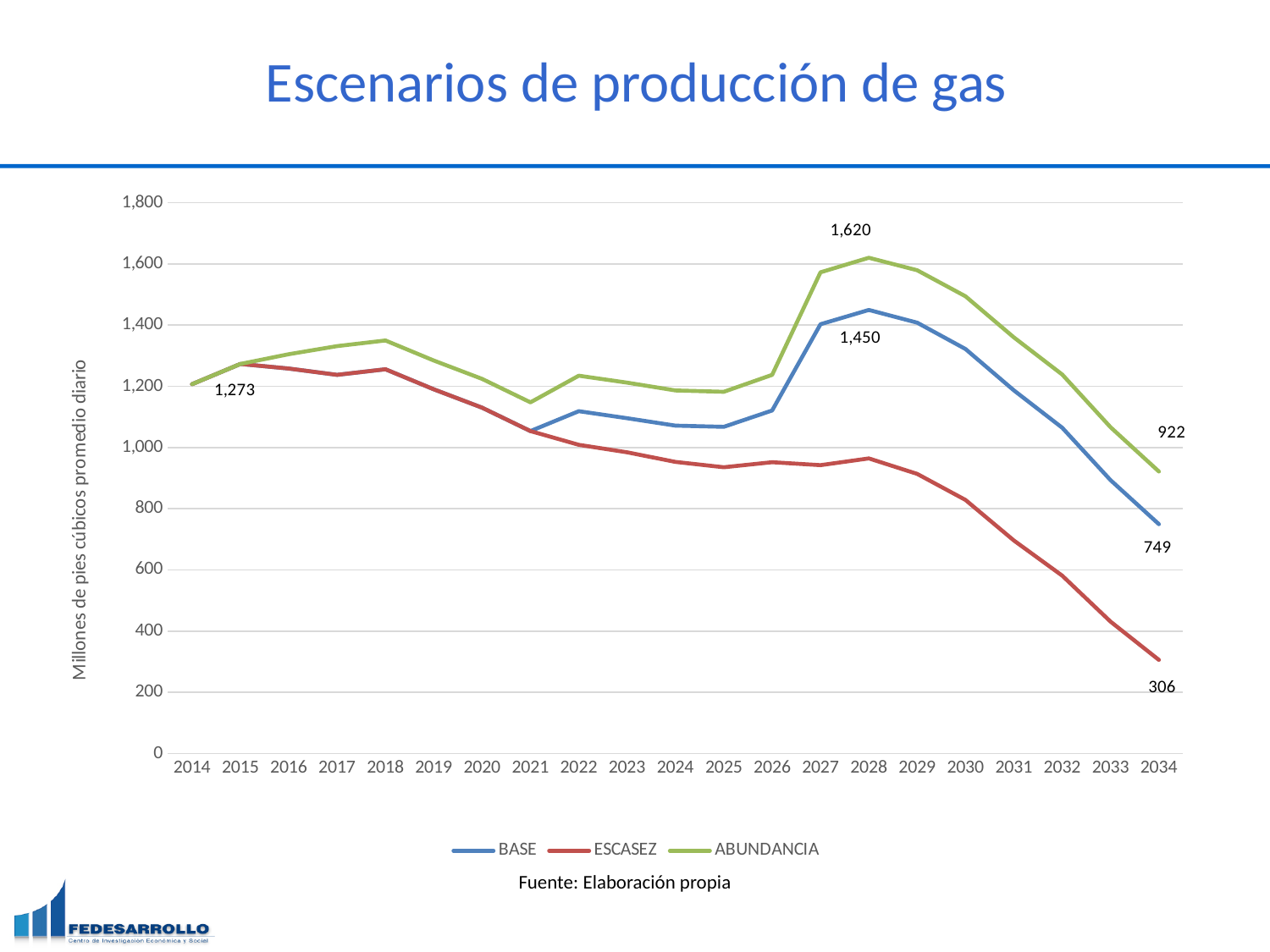
What is the difference between the ABUNDANCIA and BASE values in 2028? 170 Is the value for ESCASEZ in 2030 greater or less than 1,000? less What is the value of the ABUNDANCIA series in 2034? 922 What kind of chart is shown on the slide? line chart Does the ESCASEZ series rise or fall between 2028 and 2034? fall What is the value of the BASE series in 2034? 749 Which series has the highest value in 2034? ABUNDANCIA How many series does the legend list? 3 What is the value of the ESCASEZ series in 2034? 306 In 2034, which is larger: the BASE value or the ESCASEZ value? BASE What is the difference between the BASE and ESCASEZ values in 2034? 443 What is the value of the ABUNDANCIA series in 2028? 1,620